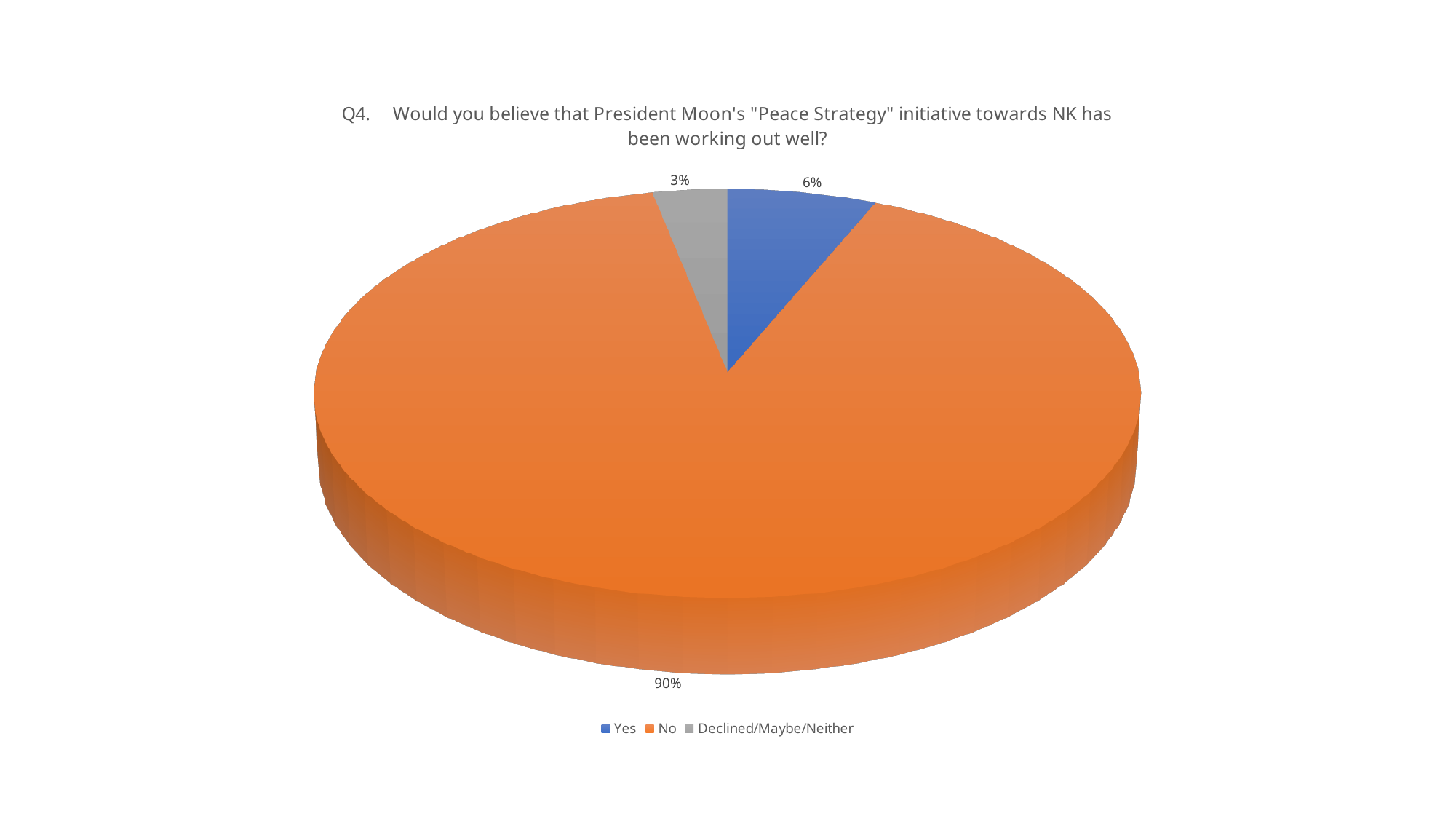
What share of respondents answered "Declined/Maybe/Neither"? 3% What colour is the "No" slice? orange Which response has the largest slice of the pie? No What is the difference in percentage points between the "No" and "Yes" slices? 84 Which slice is larger, "Yes" or "Declined/Maybe/Neither"? Yes Which response has the smallest slice of the pie? Declined/Maybe/Neither How many entries does the legend list? 3 What share of respondents answered "No"? 90% What kind of chart is shown on the slide? pie chart What share of respondents answered "Yes"? 6% How many slices does the pie chart have? 3 What is the title of the chart? Q4. Would you believe that President Moon's "Peace Strategy" initiative towards NK has been working out well?